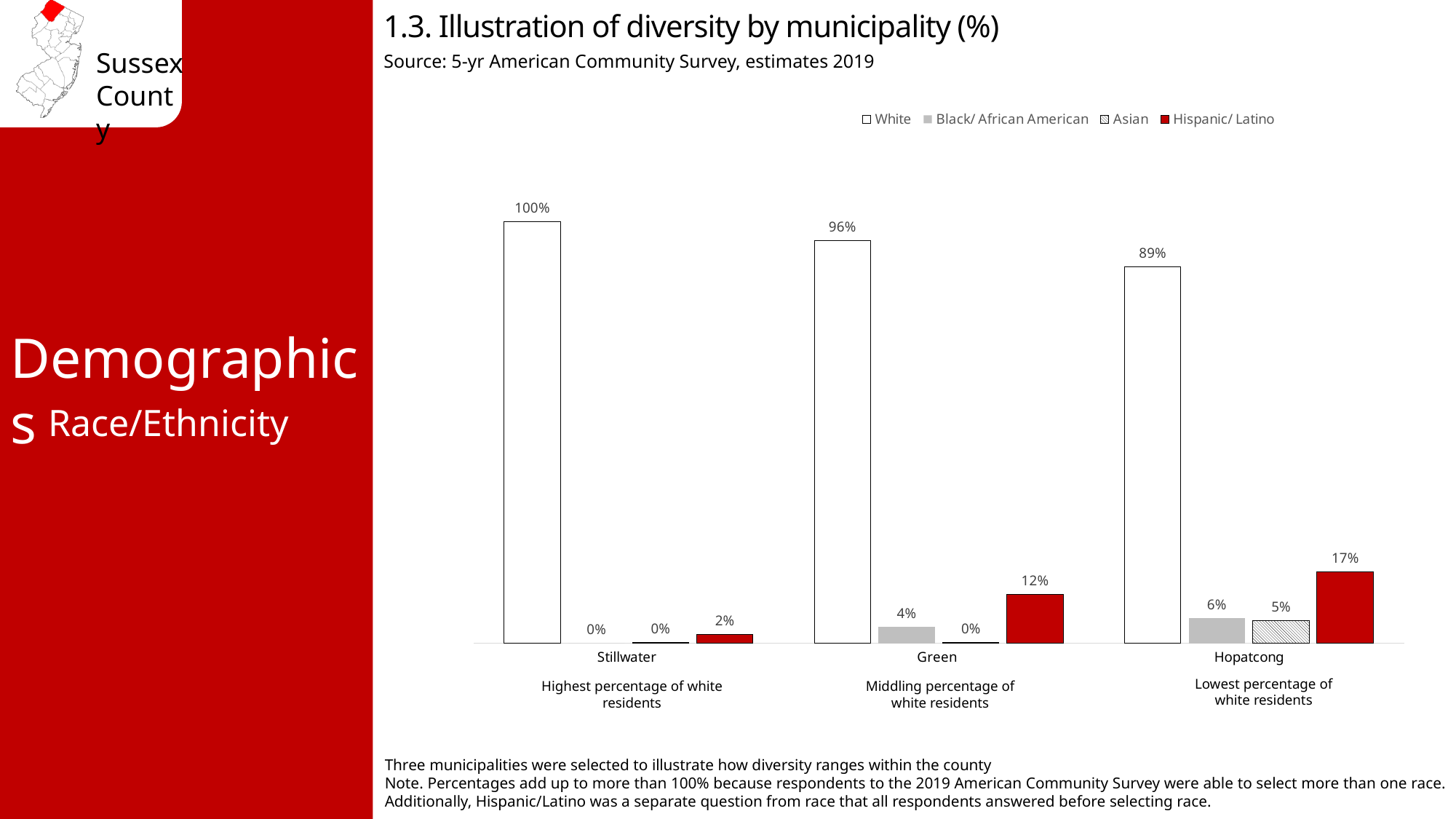
What is the Hispanic/ Latino percentage for Hopatcong? 17% Which municipality has the lowest White percentage? Hopatcong What is the difference between the White percentage for Stillwater and for Hopatcong? 11% What is the Black/ African American percentage for Green? 4% Which series is shown in red? Hispanic/ Latino Which is larger: the Hispanic/ Latino percentage for Green or for Stillwater? Green What is the White percentage for Stillwater? 100% How many series does the legend list? 4 What kind of chart is this? Bar chart What is the Asian percentage for Hopatcong? 5% Which municipality has the highest Hispanic/ Latino percentage? Hopatcong How many municipalities are shown on the x axis? 3